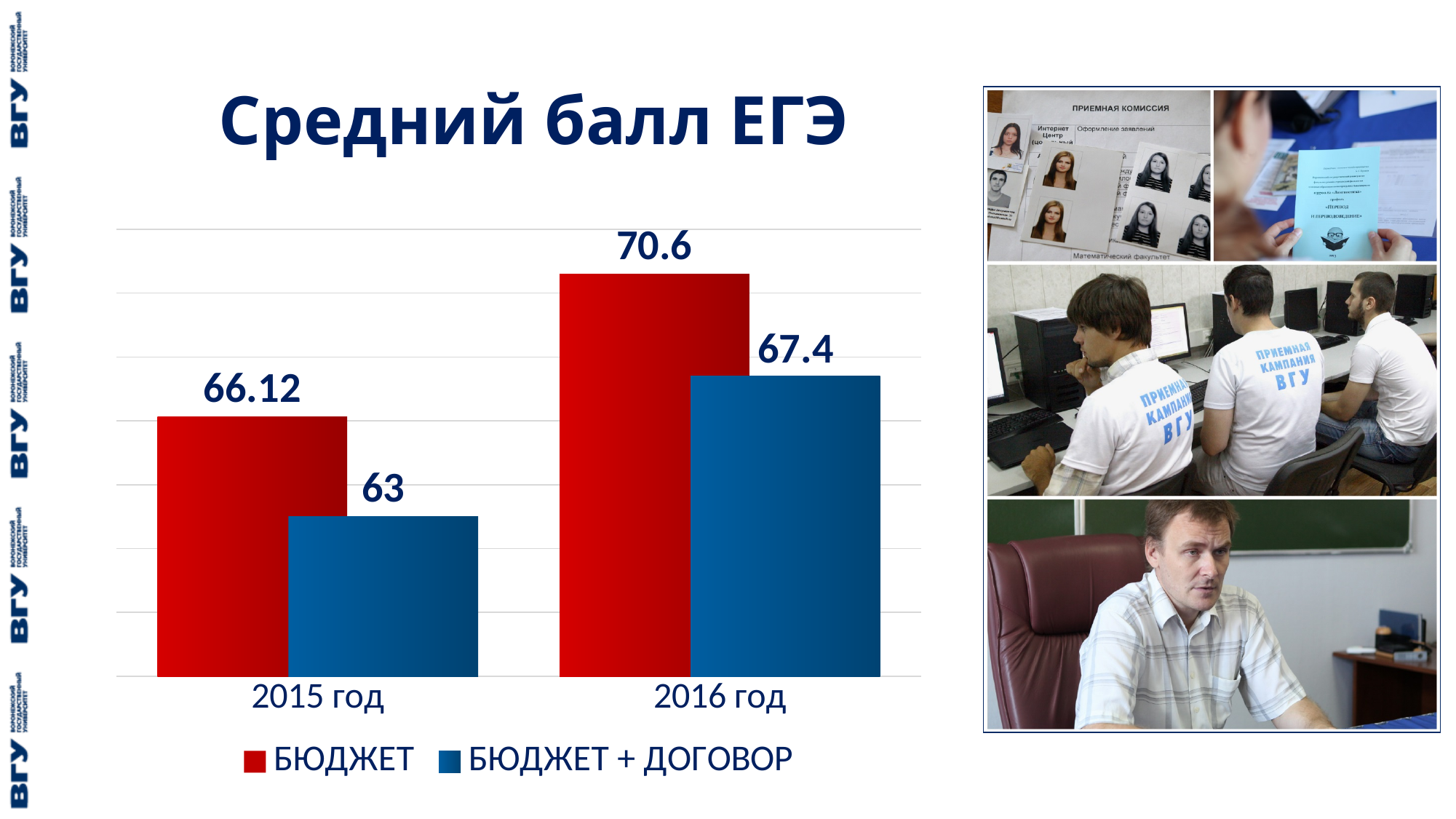
Which bar has the lowest value on the chart? БЮДЖЕТ + ДОГОВОР in 2015 год Which is larger in 2015 год: БЮДЖЕТ or БЮДЖЕТ + ДОГОВОР? БЮДЖЕТ What is the value for БЮДЖЕТ + ДОГОВОР in 2015 год? 63 What is the value for БЮДЖЕТ in 2016 год? 70.6 What is the value for БЮДЖЕТ + ДОГОВОР in 2016 год? 67.4 What is the difference between БЮДЖЕТ and БЮДЖЕТ + ДОГОВОР in 2016 год? 3.2 What kind of chart is shown on the slide? bar chart What is the value for БЮДЖЕТ in 2015 год? 66.12 Do the БЮДЖЕТ + ДОГОВОР values rise or fall from 2015 год to 2016 год? rise How many series does the legend list? 2 Which year has the highest value for БЮДЖЕТ? 2016 год What is the difference between the БЮДЖЕТ values for 2016 год and 2015 год? 4.48